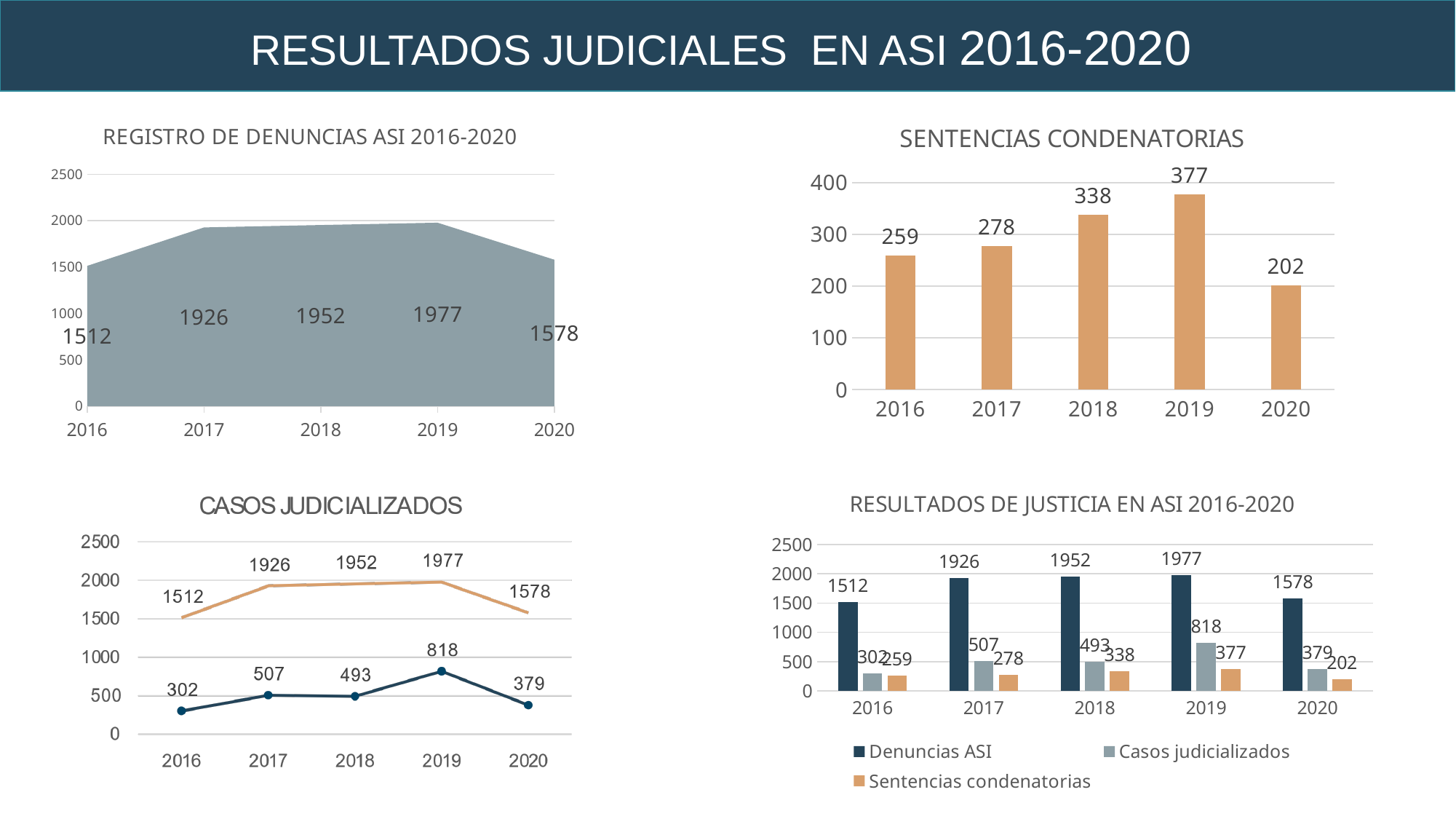
In the 'CASOS JUDICIALIZADOS' chart, what is the value of the lower (dark blue) line for 2017? 507 In the 'RESULTADOS DE JUSTICIA EN ASI 2016-2020' chart, what is the value of 'Casos judicializados' for 2018? 493 In the 'REGISTRO DE DENUNCIAS ASI 2016-2020' chart, which year has the lowest value? 2016 How many years are shown on the x axis of the 'CASOS JUDICIALIZADOS' chart? 5 How many series does the legend of the 'RESULTADOS DE JUSTICIA EN ASI 2016-2020' chart list? 3 In the 'RESULTADOS DE JUSTICIA EN ASI 2016-2020' chart, which is larger for 2020: 'Casos judicializados' or 'Sentencias condenatorias'? Casos judicializados In the 'REGISTRO DE DENUNCIAS ASI 2016-2020' chart, what is the value for 2019? 1977 In the 'SENTENCIAS CONDENATORIAS' chart, which year has the highest value? 2019 In the 'SENTENCIAS CONDENATORIAS' chart, what is the difference between the 2019 and 2020 values? 175 In the 'SENTENCIAS CONDENATORIAS' chart, what is the value for 2018? 338 What kind of chart is 'SENTENCIAS CONDENATORIAS'? Bar chart In the 'CASOS JUDICIALIZADOS' chart, which year has the highest value on the lower (dark blue) line? 2019